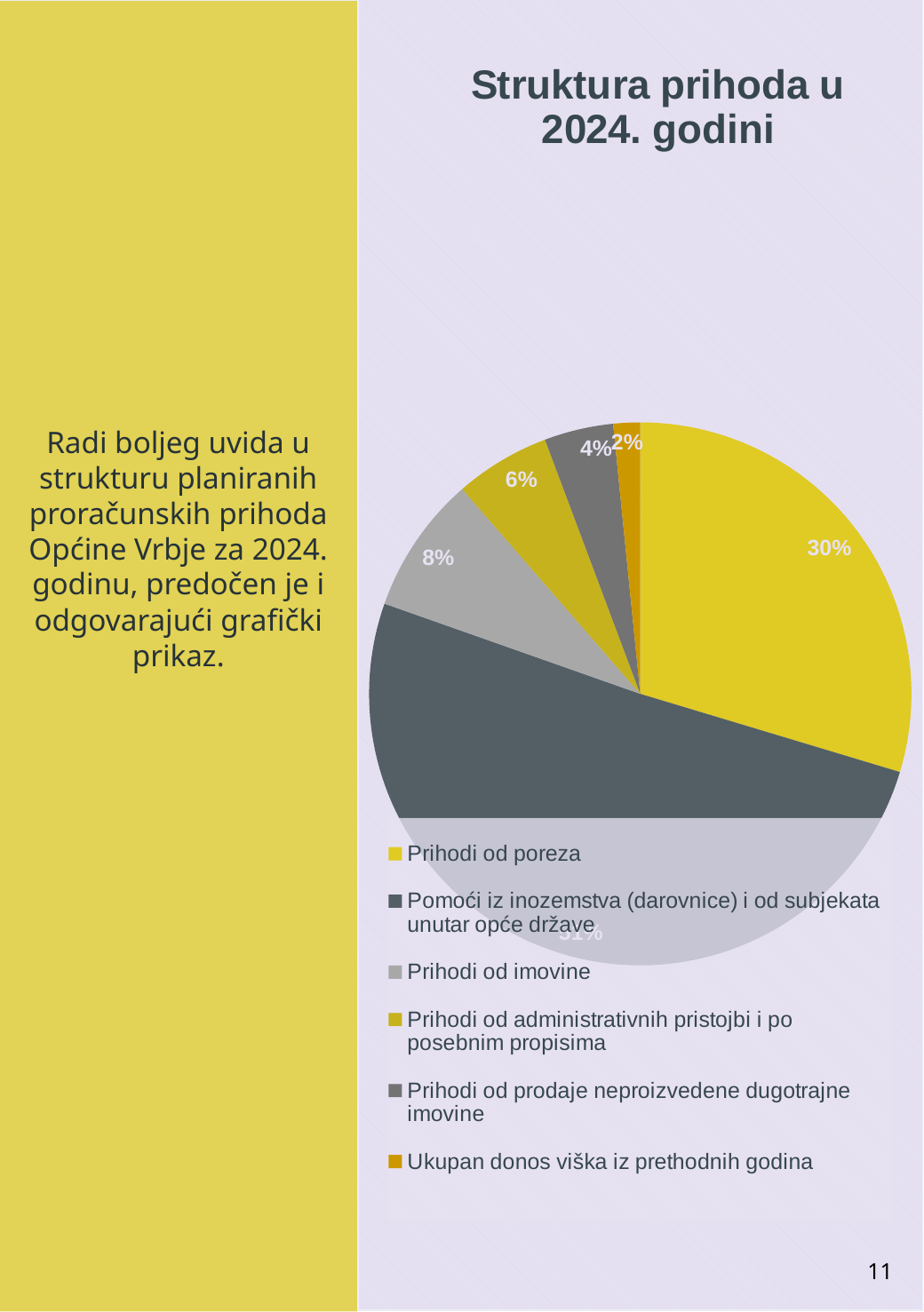
What share of the pie does Prihodi od prodaje neproizvedene dugotrajne imovine represent? 4% What is the title of the chart? Struktura prihoda u 2024. godini What share of the pie does Prihodi od imovine represent? 8% Which is larger, the share for Prihodi od imovine or the share for Prihodi od prodaje neproizvedene dugotrajne imovine? Prihodi od imovine What share of the pie does Prihodi od administrativnih pristojbi i po posebnim propisima represent? 6% Which category has the largest slice of the pie? Pomoći iz inozemstva (darovnice) i od subjekata unutar opće države How many categories does the legend of the pie chart list? 6 What kind of chart is shown on the slide? pie chart What is the difference in percentage points between Prihodi od poreza and Prihodi od imovine? 22 Which category has the smallest slice of the pie? Ukupan donos viška iz prethodnih godina